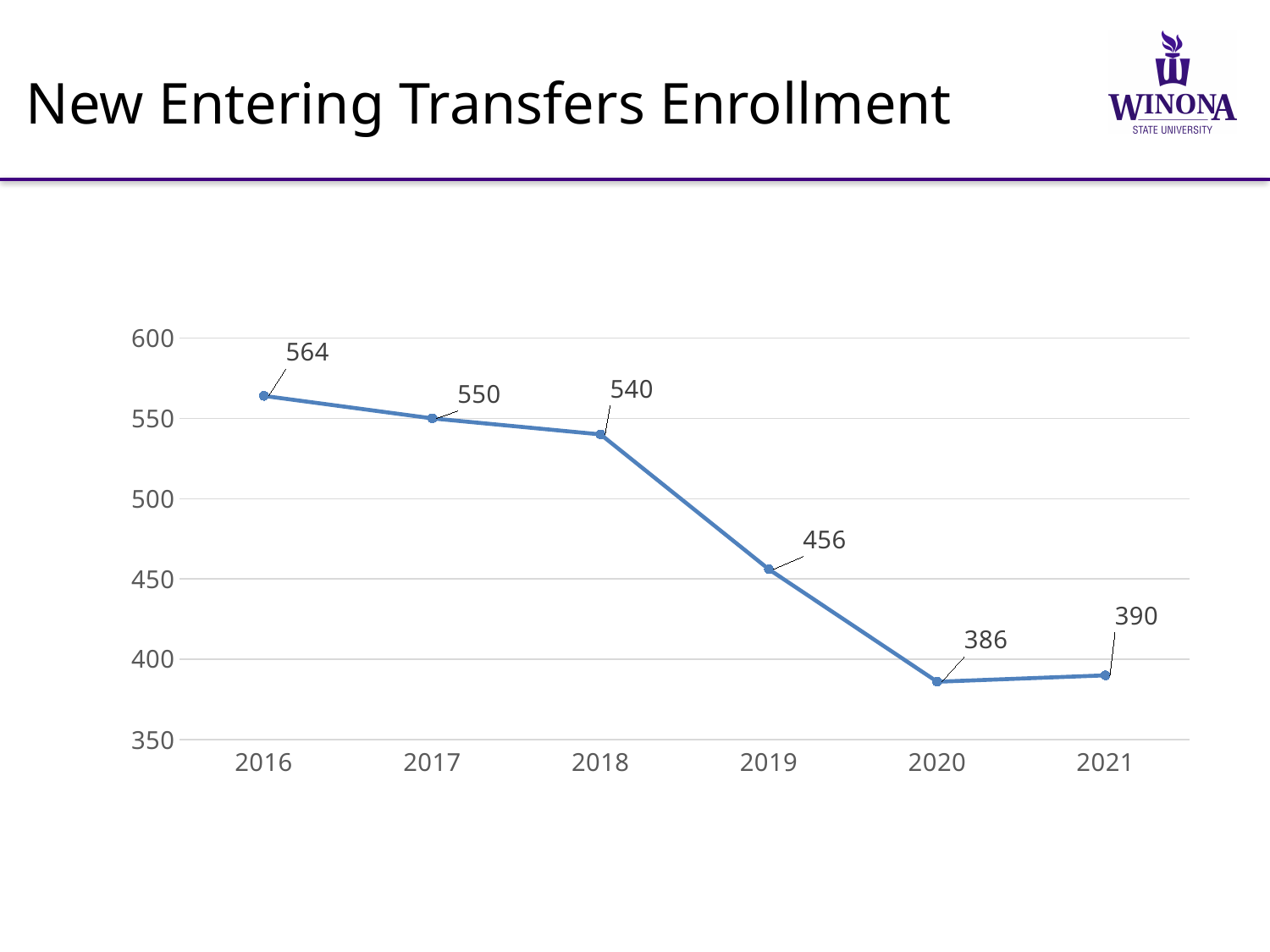
Which year had the highest new entering transfers enrollment? 2016 Which year had the lowest new entering transfers enrollment? 2020 What was the new entering transfers enrollment in 2019? 456 What is the difference in enrollment between 2018 and 2019? 84 What is the difference in enrollment between 2016 and 2021? 174 How many years are shown on the x axis? 6 What was the new entering transfers enrollment in 2021? 390 Which year had higher enrollment, 2017 or 2020? 2017 What was the new entering transfers enrollment in 2016? 564 Does enrollment generally rise or fall from 2016 to 2020? fall Is the enrollment value for 2019 greater or less than 500? less What kind of chart is shown on the slide? line chart